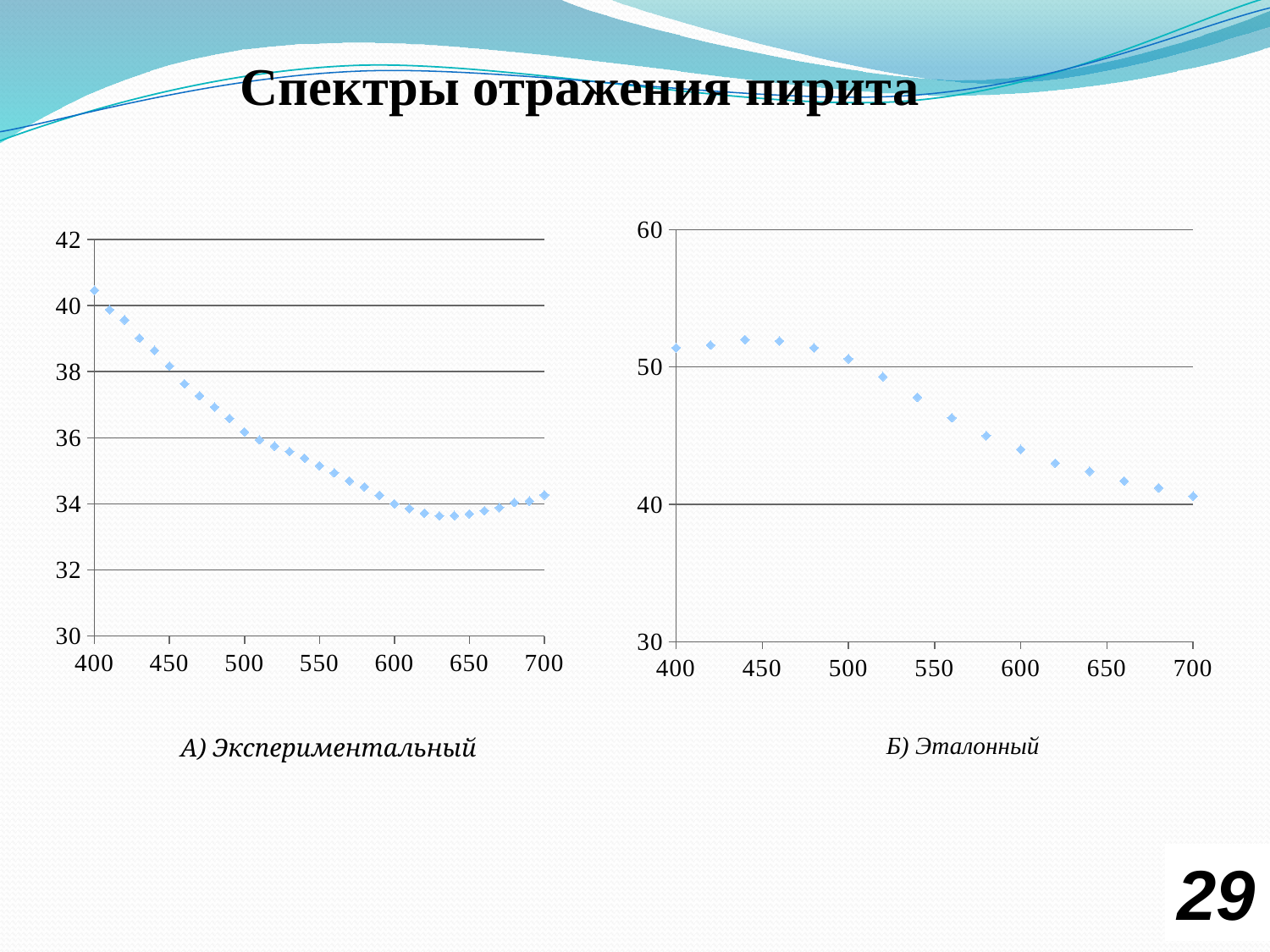
In the left chart (А) Экспериментальный), do the values rise or fall from 400 to 600 along the x axis? fall In the right chart (Б) Эталонный), is the value at 400 greater or less than 50? greater In the left chart (А) Экспериментальный), which is larger, the value at 400 or the value at 700? 400 In the left chart (А) Экспериментальный), is the value at 550 greater or less than 36? less In the left chart (А) Экспериментальный), at which x value is the plotted value highest? 400 In the left chart (А) Экспериментальный), is the value at 400 greater or less than 40? greater What is the title of the slide containing the two charts? Спектры отражения пирита What kind of chart is the right chart (Б) Эталонный)? scatter chart In the right chart (Б) Эталонный), do the values generally rise or fall from 500 to 700 along the x axis? fall What kind of chart is the left chart (А) Экспериментальный)? scatter chart